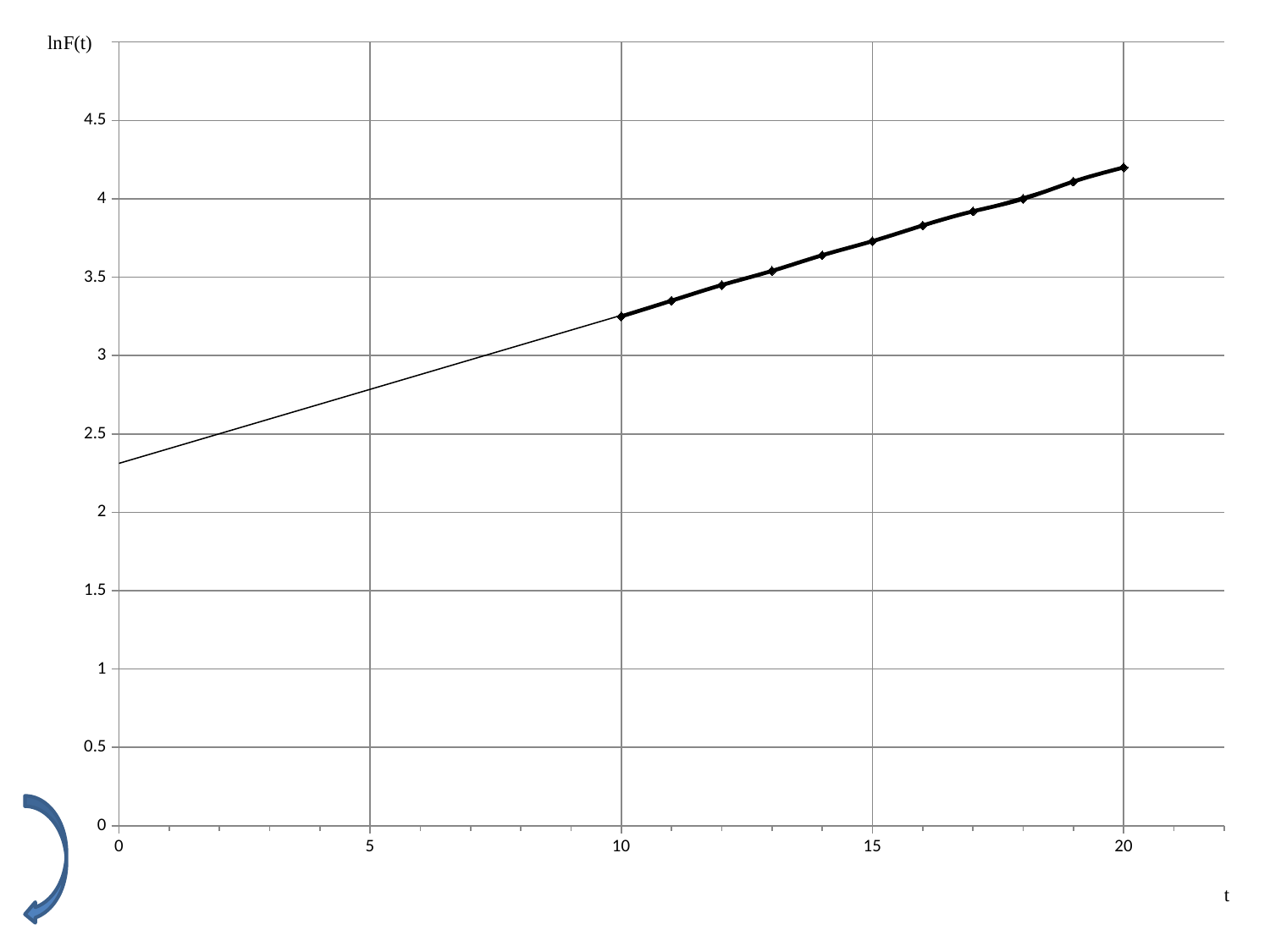
What is the label on the vertical axis? lnF(t) Is the value of lnF(t) at t = 10 greater or less than 3.5? less How many marked data points are plotted on the line? 11 What kind of chart is shown on the slide? line chart What is the label on the horizontal axis? t At which value of t is the marked data point highest? 20 Do the values of lnF(t) rise or fall as t increases? rise At which value of t is the marked data point lowest? 10 Is the value of lnF(t) at t = 20 greater or less than 4? greater Which is larger, the value of lnF(t) at t = 20 or at t = 10? t = 20 Is the value of lnF(t) at t = 12 greater or less than 3? greater